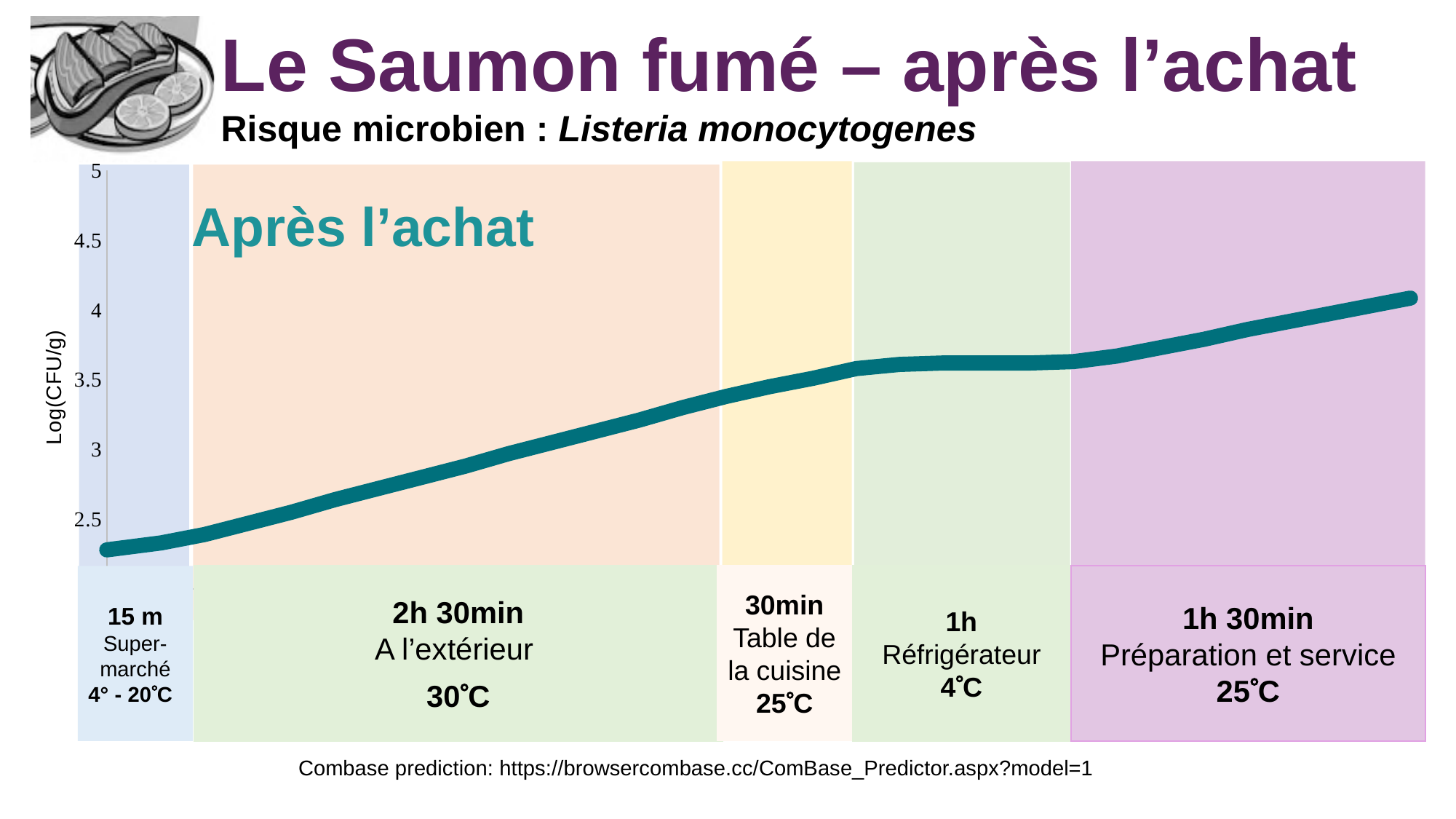
Is the value at the end of the A l'extérieur stage greater or less than 3? greater Is the value at the end of the Réfrigérateur stage greater or less than 3.5? greater What is the label on the y axis of the chart? Log(CFU/g) Does the plotted line rise or fall from left to right across the chart? rise What kind of chart is shown on the slide? line chart Is the value at the start of the line (beginning of the Supermarché stage) greater or less than 2.5? less Which stage has the higher value on the line: the end of the Supermarché stage or the end of the Table de la cuisine stage? Table de la cuisine Which stage on the x axis lasts 2h 30min? A l'extérieur How many stages (time periods) are marked along the x axis of the chart? 5 How many lines are plotted on the chart? 1 What title is written inside the chart area? Après l'achat